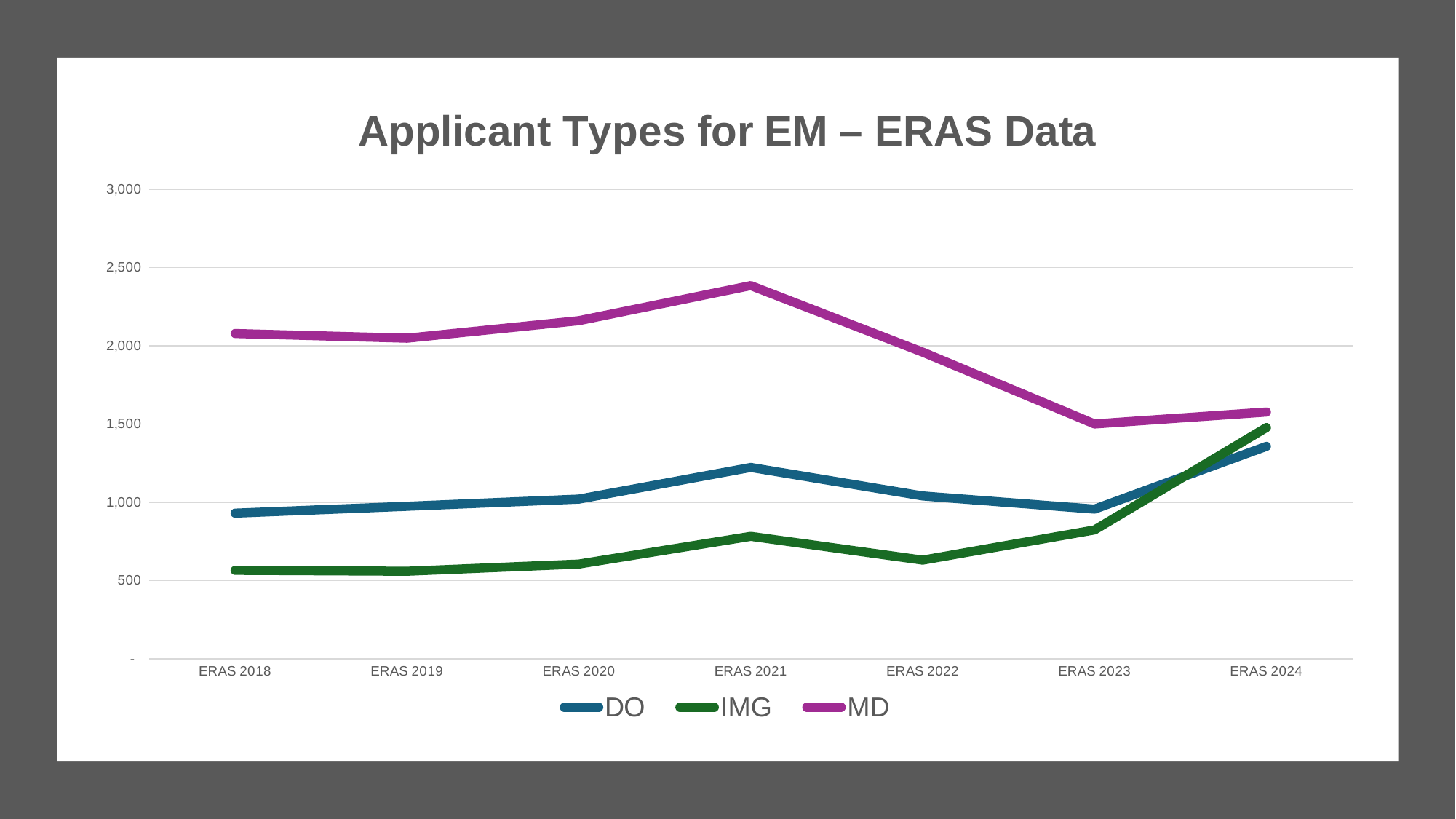
In which ERAS year does the IMG series reach its highest value? ERAS 2024 Is the value for DO at ERAS 2024 greater or less than 1,500? less What is the title of the chart? Applicant Types for EM – ERAS Data Does the MD series rise or fall from ERAS 2021 to ERAS 2023? fall What kind of chart is shown on the slide? Line chart How many series does the legend list? 3 Is the value for MD at ERAS 2021 greater or less than 2,000? greater Which series is shown in purple in the legend? MD In which ERAS year does the MD series reach its highest value? ERAS 2021 In which ERAS year does the MD series reach its lowest value? ERAS 2023 Which is larger at ERAS 2021, the MD value or the DO value? MD How many ERAS years are plotted along the x axis? 7